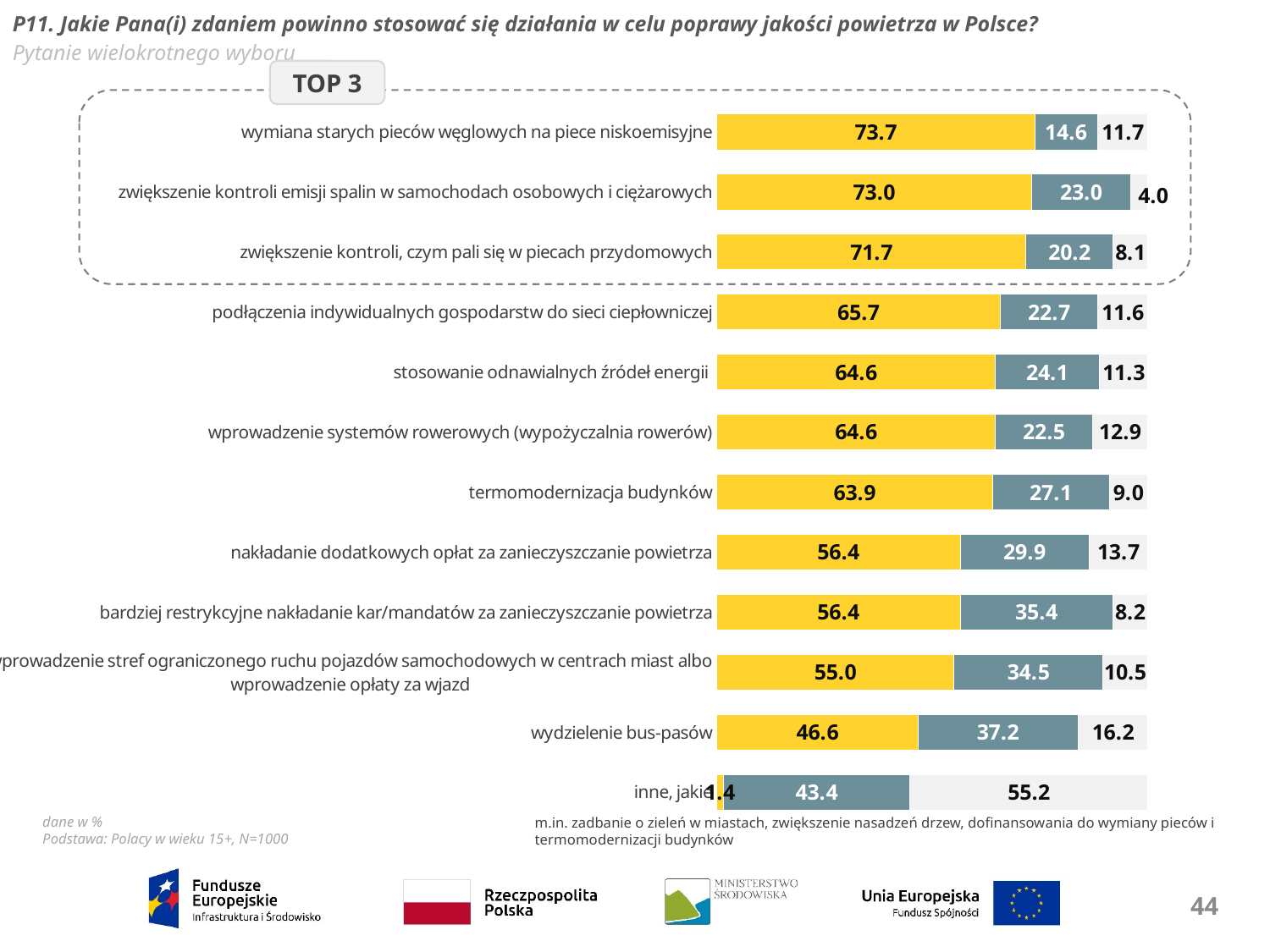
How many categories are shown in the chart? 12 What label is shown on the box enclosing the first three categories of the chart? TOP 3 What is the value of the light grey segment for "wprowadzenie systemów rowerowych (wypożyczalnia rowerów)"? 12.9 What kind of chart is shown on the slide? stacked bar chart What is the value of the yellow segment for "termomodernizacja budynków"? 63.9 What is the total of the three segments for "wydzielenie bus-pasów"? 100.0 Which category has the highest yellow segment value? wymiana starych pieców węglowych na piece niskoemisyjne What is the difference between the grey-blue segment values for "wydzielenie bus-pasów" and "termomodernizacja budynków"? 10.1 Which has the larger grey-blue segment value: "bardziej restrykcyjne nakładanie kar/mandatów za zanieczyszczanie powietrza" or "nakładanie dodatkowych opłat za zanieczyszczanie powietrza"? bardziej restrykcyjne nakładanie kar/mandatów za zanieczyszczanie powietrza What is the value of the grey-blue segment for "wydzielenie bus-pasów"? 37.2 Which category has the lowest light grey segment value? zwiększenie kontroli emisji spalin w samochodach osobowych i ciężarowych What is the difference between the yellow segment values for "wymiana starych pieców węglowych na piece niskoemisyjne" and "zwiększenie kontroli emisji spalin w samochodach osobowych i ciężarowych"? 0.7